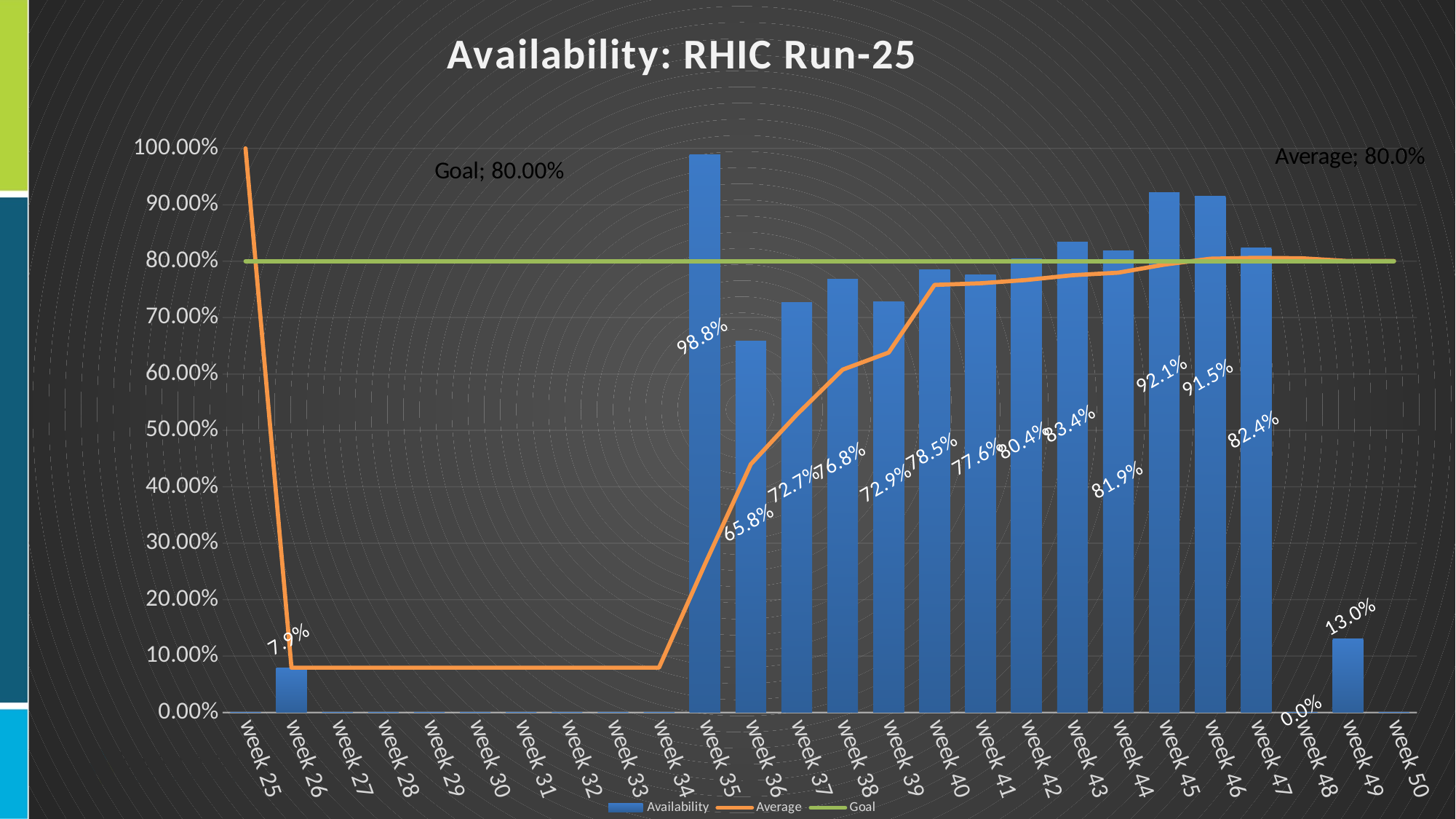
Is the availability value for week 36 greater or less than 70.00%? less What kind of chart is used for the Availability series? bar chart What is the availability value for week 49? 13.0% How many series does the legend list? 3 What goal value is labelled on the chart? 80.00% How many weeks are shown on the x axis? 26 What is the difference between the availability for week 35 and week 36? 33.0% Which week has the highest availability? week 35 What is the availability value for week 35? 98.8% What is the availability value for week 45? 92.1% What is the difference between the availability for week 45 and week 46? 0.6% Which is larger, the availability for week 43 or week 44? week 43